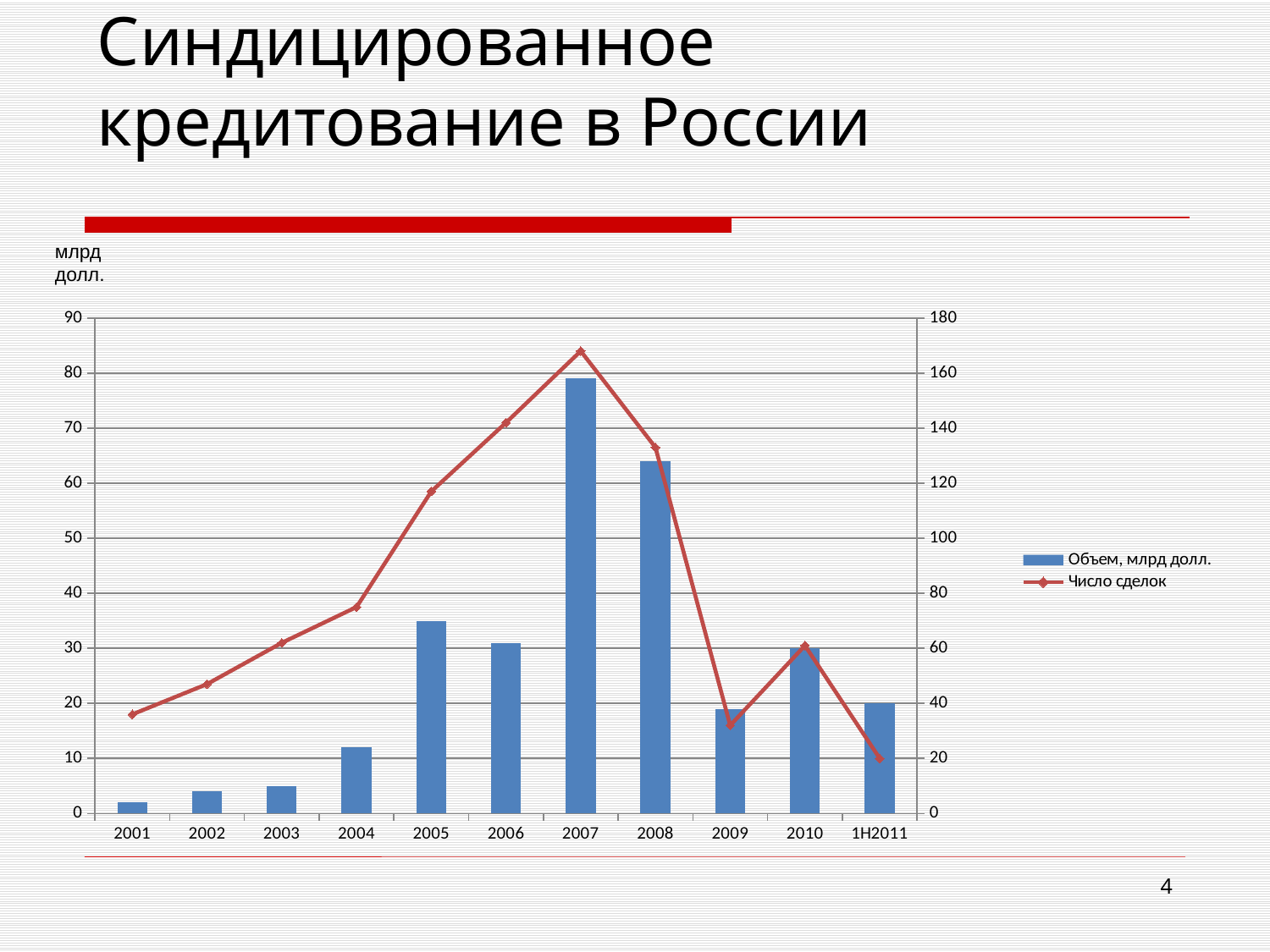
Which year has the highest bar for Объем, млрд долл.? 2007 In which year does the Число сделок line reach its highest point? 2007 How many categories are shown on the x axis? 11 What are the two entries listed in the legend? Объем, млрд долл. and Число сделок Is the value of Число сделок for 2009 greater or less than 40? less How many series does the legend list? 2 Which year has the lowest bar for Объем, млрд долл.? 2001 Is the value of Объем, млрд долл. for 2008 greater or less than 60? greater Which year has the larger bar for Объем, млрд долл., 2008 or 2010? 2008 Do the bars for Объем, млрд долл. rise or fall from 2001 to 2007? rise In which period does the Число сделок line reach its lowest point? 1H2011 What kind of chart is shown on the slide? A combined bar and line chart